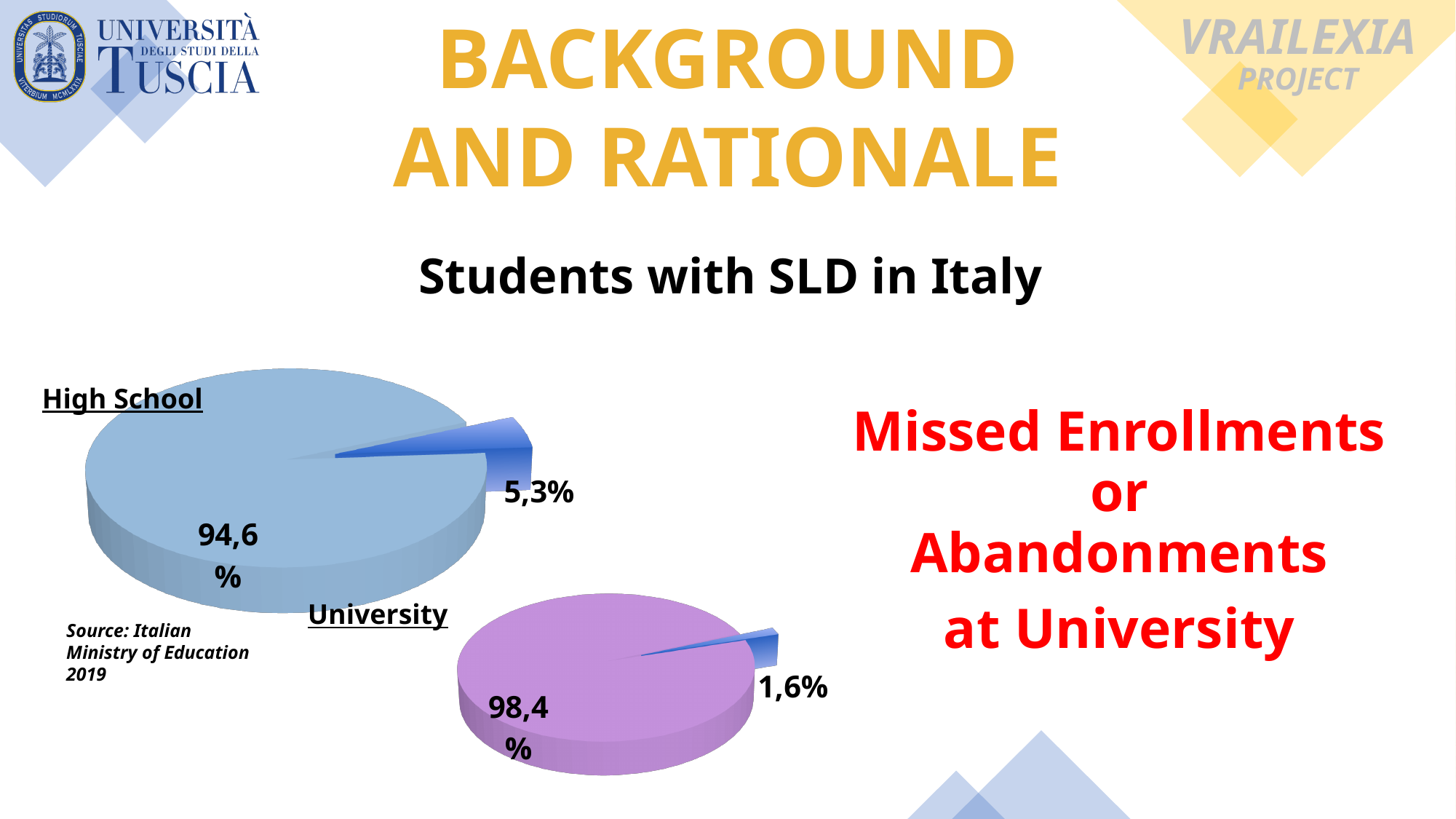
How many slices does the University pie chart have? 2 What is the difference between the small slice of the High School pie chart (5,3%) and the small slice of the University pie chart (1,6%)? 3,7% In the University pie chart, what value is shown for the large purple slice? 98,4% What colour is the large slice of the University pie chart? purple In the High School pie chart, what value is shown for the large blue slice? 94,6% What is the title above the pie charts? Students with SLD in Italy How many pie charts are shown on the slide? 2 Which is larger: the small slice in the High School pie chart or the small slice in the University pie chart? High School (5,3%) How many slices does the High School pie chart have? 2 In the University pie chart, what value is shown for the small pulled-out slice? 1,6% In the High School pie chart, what value is shown for the small pulled-out slice? 5,3% What type of chart is used for the High School data? pie chart